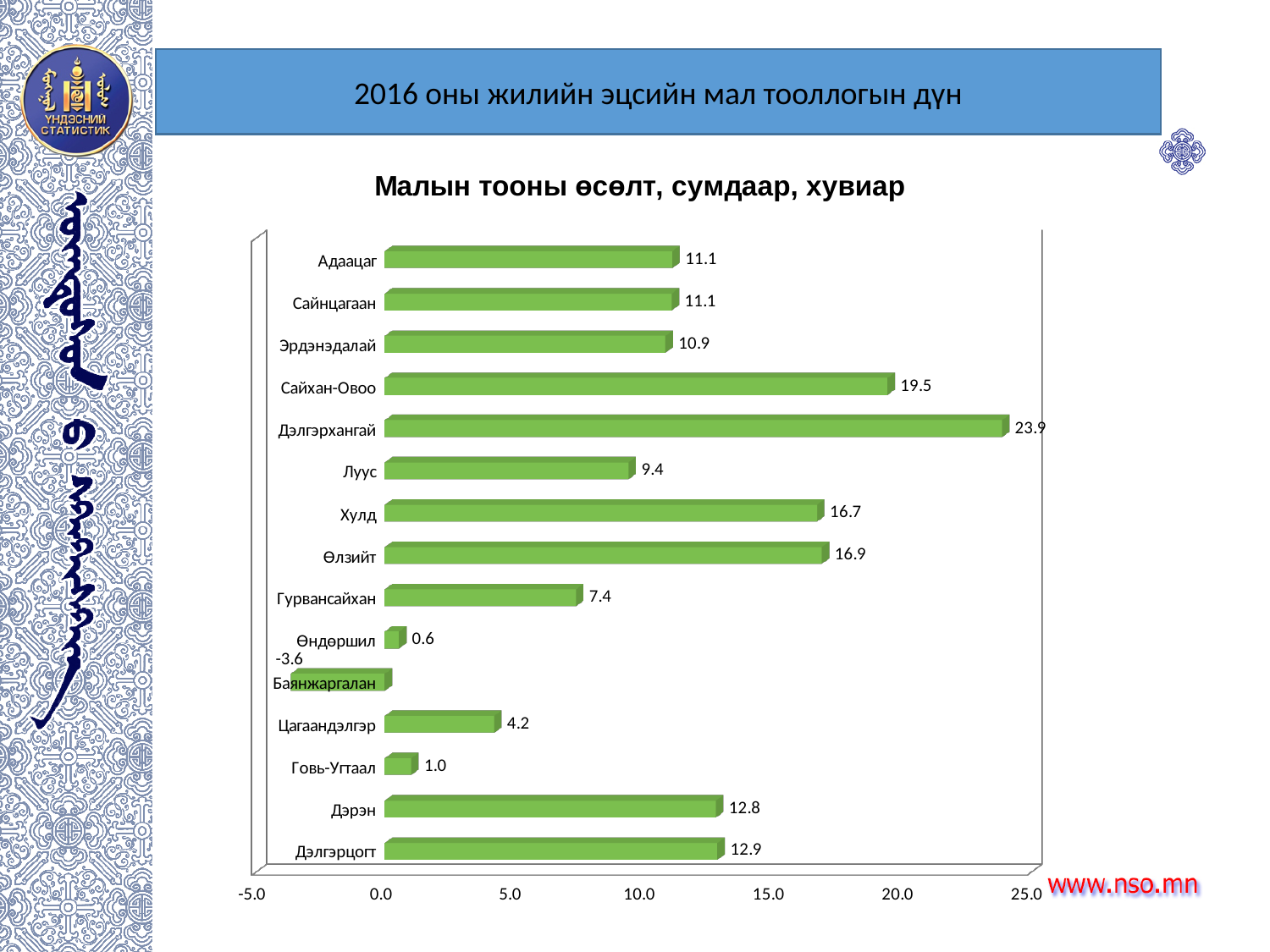
Which category has the highest value? Дэлгэрхангай What is the value for Сайхан-Овоо? 19.5 Which category has the lowest value? Баянжаргалан What is the difference between the values for Дэлгэрхангай and Сайхан-Овоо? 4.4 Which is larger, the value for Хулд or the value for Луус? Хулд What is the value for Баянжаргалан? -3.6 What kind of chart is shown on the slide? Bar chart What is the value for Дэлгэрхангай? 23.9 What is the value for Гурвансайхан? 7.4 What is the title of the chart? Малын тооны өсөлт, сумдаар, хувиар How many categories are shown in the chart? 15 Is the value for Дэрэн greater or less than 10.0? greater